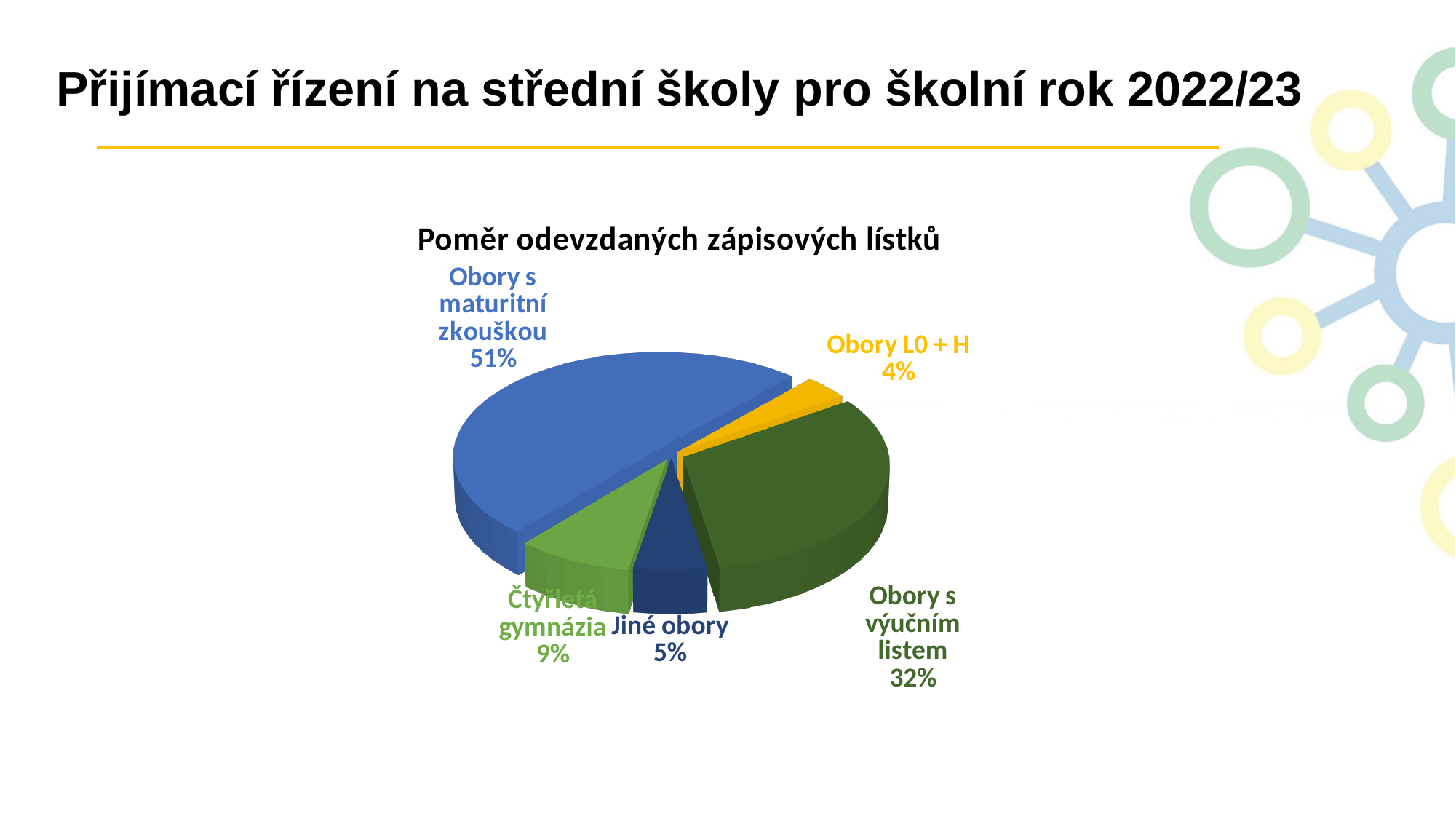
Which category has the largest slice of the pie? Obory s maturitní zkouškou What is the difference in percentage points between 'Obory s maturitní zkouškou' and 'Obory s výučním listem'? 19 What is the value shown for 'Obory s výučním listem'? 32% What is the value for 'Jiné obory'? 5% Which category has the smallest slice of the pie? Obory L0 + H What share of the pie does 'Obory s maturitní zkouškou' represent? 51% What share is shown for 'Obory L0 + H'? 4% What percentage is labelled for 'Čtyřletá gymnázia'? 9% Which is larger: 'Čtyřletá gymnázia' or 'Jiné obory'? Čtyřletá gymnázia What kind of chart is shown on the slide? Pie chart How many categories are shown in the pie chart? 5 What is the title of the chart? Poměr odevzdaných zápisových lístků